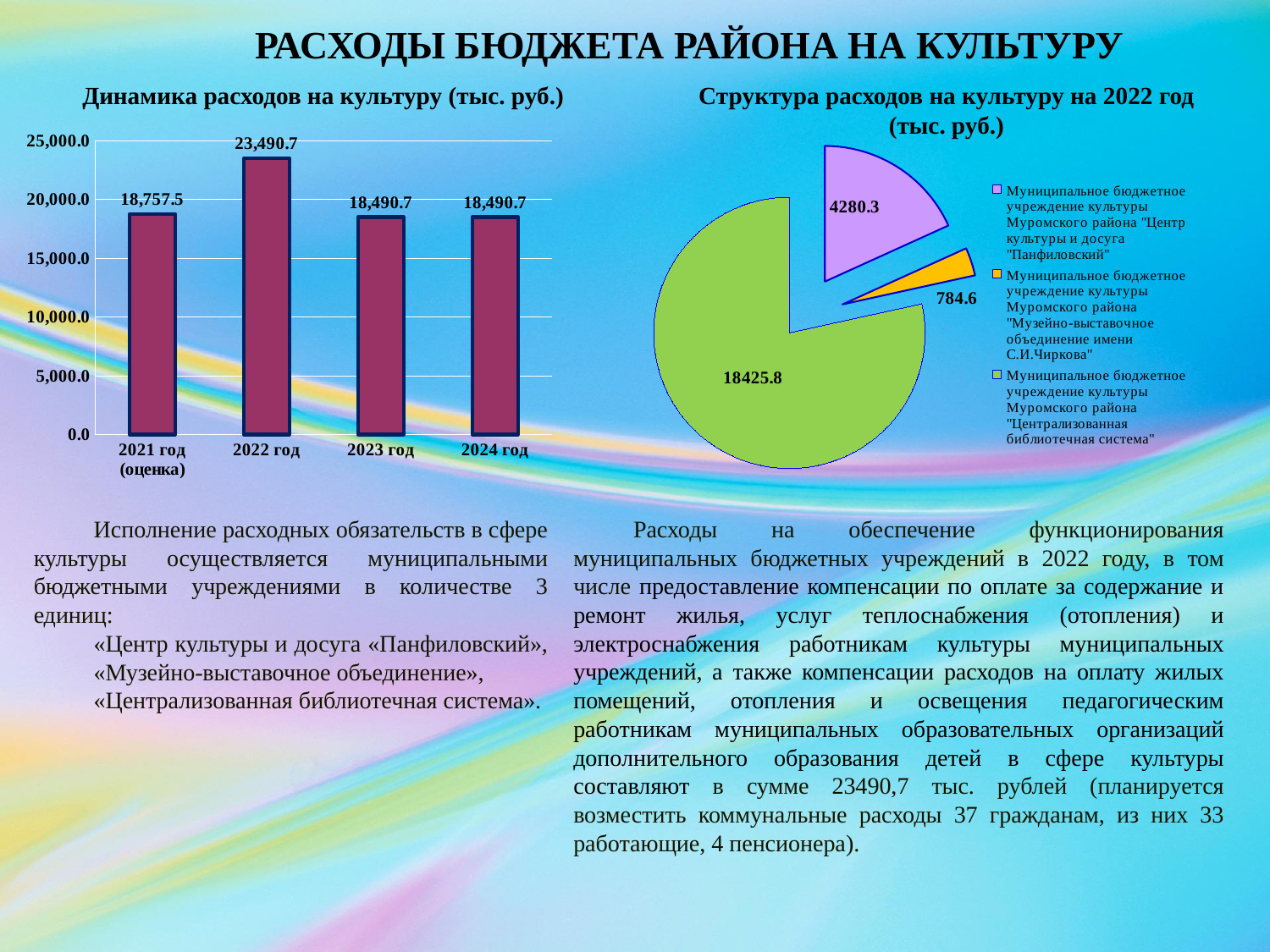
In the pie chart "Структура расходов на культуру на 2022 год (тыс. руб.)", what is the total of all slices? 23490.7 In the chart "Динамика расходов на культуру (тыс. руб.)", what is the difference between the values for 2022 год and 2023 год? 5,000.0 In the chart "Динамика расходов на культуру (тыс. руб.)", what is the value for 2021 год (оценка)? 18,757.5 In the pie chart "Структура расходов на культуру на 2022 год (тыс. руб.)", what is the value for Муниципальное бюджетное учреждение культуры Муромского района "Централизованная библиотечная система"? 18425.8 In the chart "Динамика расходов на культуру (тыс. руб.)", which year has the highest value? 2022 год In the pie chart "Структура расходов на культуру на 2022 год (тыс. руб.)", which institution has the smallest slice? Муниципальное бюджетное учреждение культуры Муромского района "Музейно-выставочное объединение имени С.И.Чиркова" In the chart "Динамика расходов на культуру (тыс. руб.)", is the value for 2022 год greater or less than 20,000.0? greater In the chart "Динамика расходов на культуру (тыс. руб.)", which is larger: the value for 2021 год (оценка) or the value for 2024 год? 2021 год (оценка) What kind of chart is "Динамика расходов на культуру (тыс. руб.)"? bar chart In the chart "Динамика расходов на культуру (тыс. руб.)", what is the value for 2022 год? 23,490.7 In the chart "Динамика расходов на культуру (тыс. руб.)", how many years are shown on the x axis? 4 How many entries does the legend of the pie chart "Структура расходов на культуру на 2022 год (тыс. руб.)" list? 3